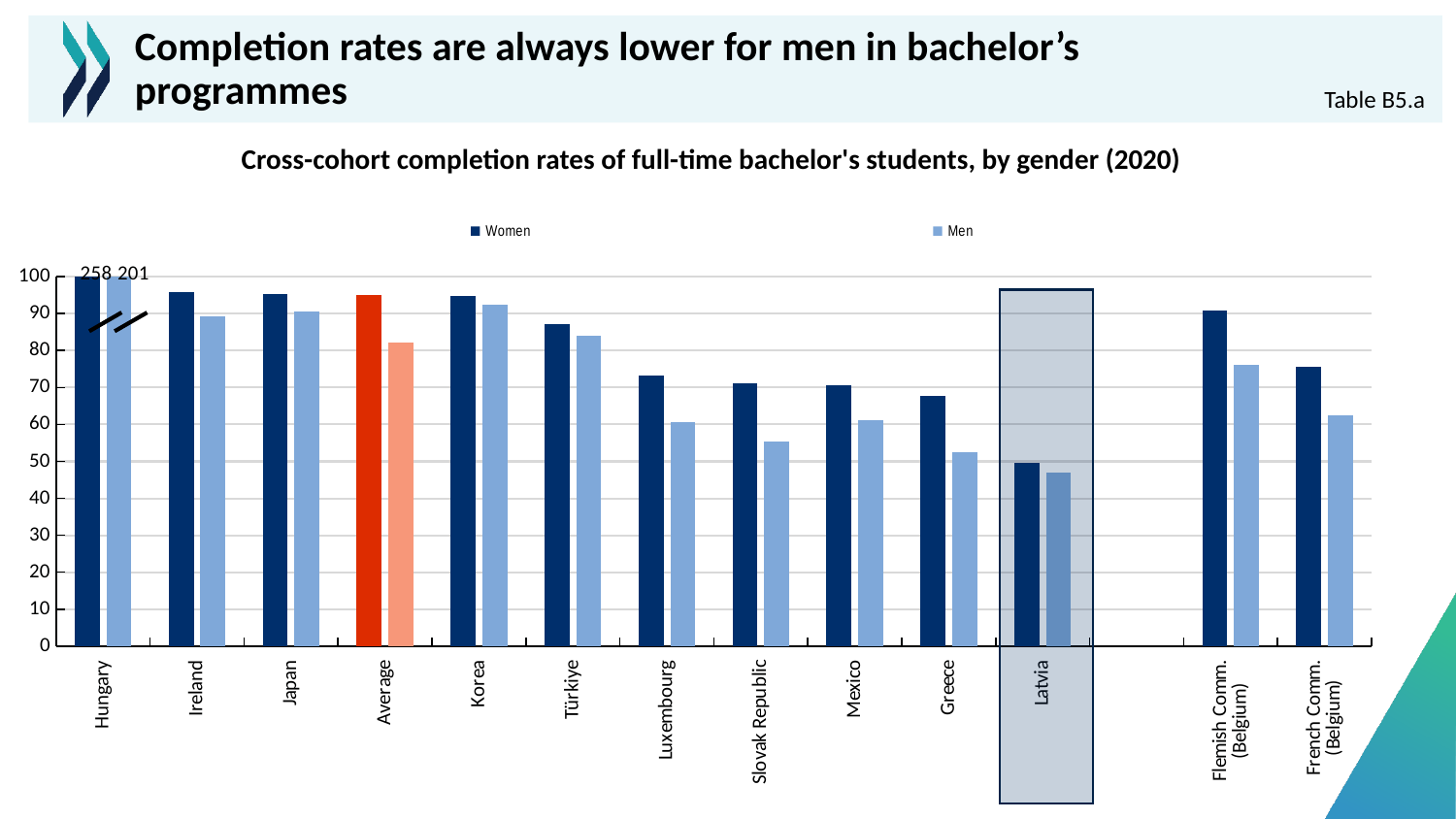
Which country has the highest completion rate for Men? Hungary Is the value for Men in Türkiye greater or less than 80? greater Which country has the lowest completion rate for Women? Latvia How many countries or categories are shown on the x axis? 13 What is the difference between the Women and Men values for Hungary? 57 What is the completion rate for Women in Hungary? 258 Which is larger in Luxembourg, the Women value or the Men value? Women How many series does the legend list? 2 What kind of chart is shown on the slide? bar chart What is the completion rate for Men in Hungary? 201 Is the value for Men in Latvia greater or less than 50? less Which country is highlighted with a box on the chart? Latvia